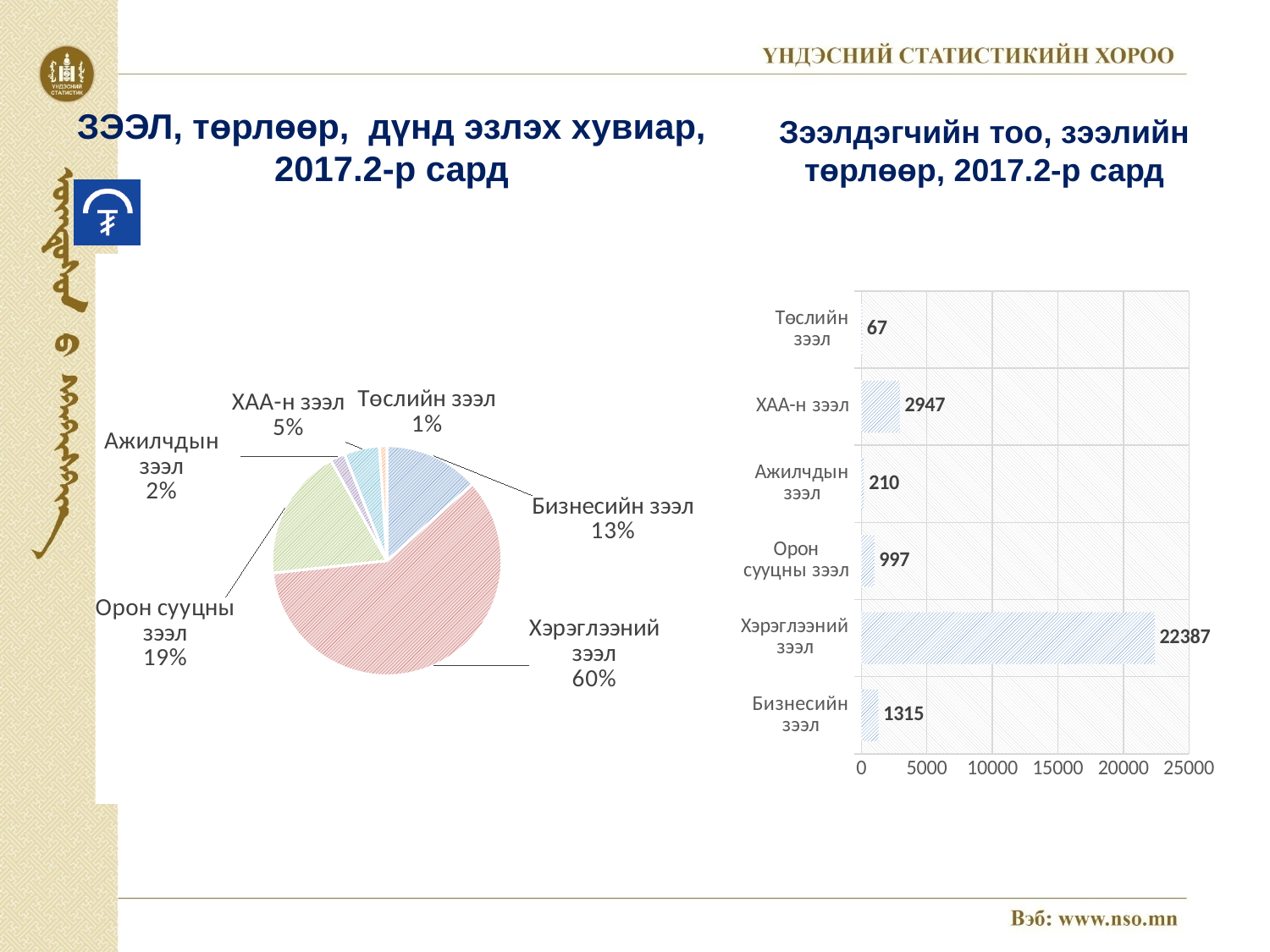
In the pie chart on the left, what share does Хэрэглээний зээл have? 60% In the pie chart on the left, what share does Орон сууцны зээл have? 19% In the bar chart on the right, what is the value for Төслийн зээл? 67 In the bar chart on the right, what is the value for ХАА-н зээл? 2947 What type of chart is the chart on the right? bar chart In the pie chart on the left, how many slices are there? 6 In the pie chart on the left, which category has the smallest share? Төслийн зээл In the bar chart on the right, which is larger: Бизнесийн зээл or Орон сууцны зээл? Бизнесийн зээл In the bar chart on the right, which category has the highest value? Хэрэглээний зээл In the bar chart on the right, what is the difference between Бизнесийн зээл and Ажилчдын зээл? 1105 In the pie chart on the left, what is the difference between the shares of Бизнесийн зээл and ХАА-н зээл? 8% In the bar chart on the right, what is the value for Хэрэглээний зээл? 22387